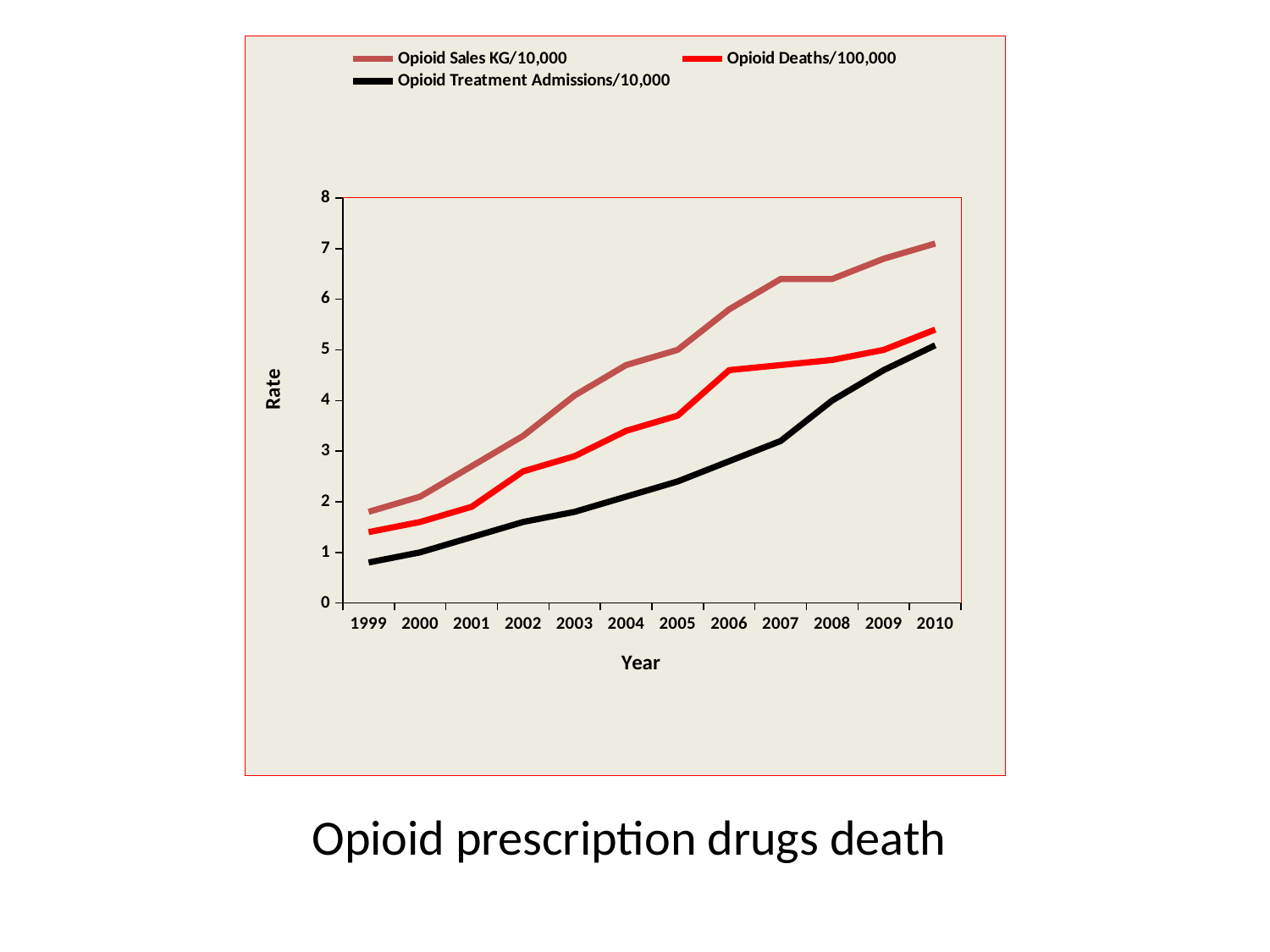
Is the value for Opioid Sales KG/10,000 in 2007 greater or less than 6? greater Does the Opioid Sales KG/10,000 line rise or fall from 1999 to 2010? Rise What is the label of the y axis? Rate Is the value for Opioid Deaths/100,000 in 1999 greater or less than 2? less What kind of chart is shown on the slide? Line chart Is the value for Opioid Deaths/100,000 in 2006 greater or less than 4? greater Which series has the highest value in 2003? Opioid Sales KG/10,000 How many years are plotted along the x axis? 12 In 2005, which is larger: Opioid Sales KG/10,000 or Opioid Deaths/100,000? Opioid Sales KG/10,000 How many series does the legend list? 3